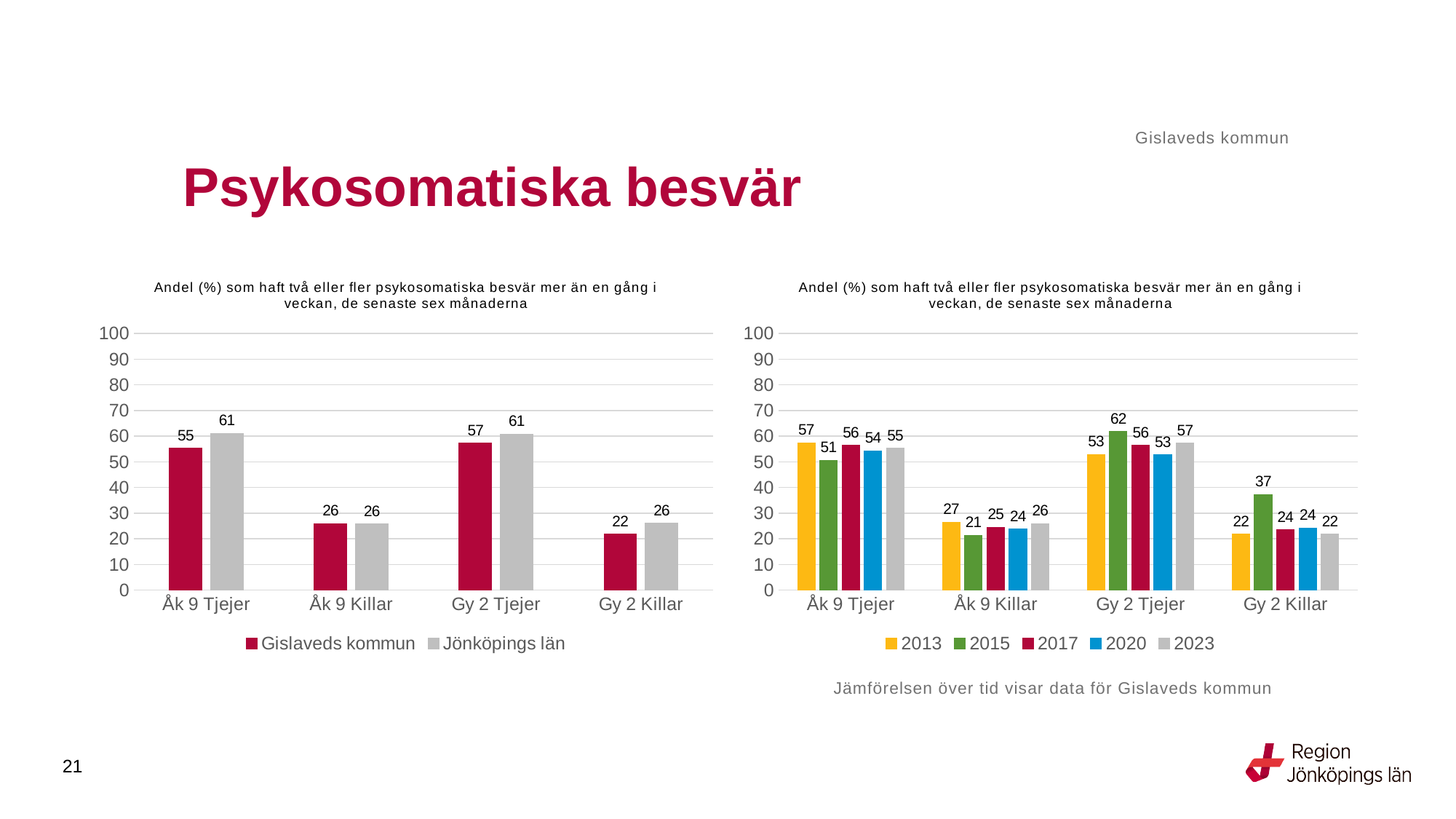
In the left chart, what is the value for Gislaveds kommun for Åk 9 Tjejer? 55 What kind of chart is the right chart? Bar chart How many series does the legend of the left chart list? 2 In the left chart, what is the difference between Jönköpings län and Gislaveds kommun for Gy 2 Tjejer? 4 In the right chart, what is the value for 2015 for Gy 2 Killar? 37 In the right chart, what is the difference between the 2013 and 2015 values for Åk 9 Killar? 6 In the left chart, which category has the lowest value for Gislaveds kommun? Gy 2 Killar In the right chart, which year has the highest value for Gy 2 Tjejer? 2015 In the left chart, what is the value for Jönköpings län for Gy 2 Killar? 26 In the right chart, what is the value for 2023 for Åk 9 Killar? 26 In the right chart, which is larger for Åk 9 Tjejer: the value for 2013 or the value for 2015? 2013 How many series does the legend of the right chart list? 5